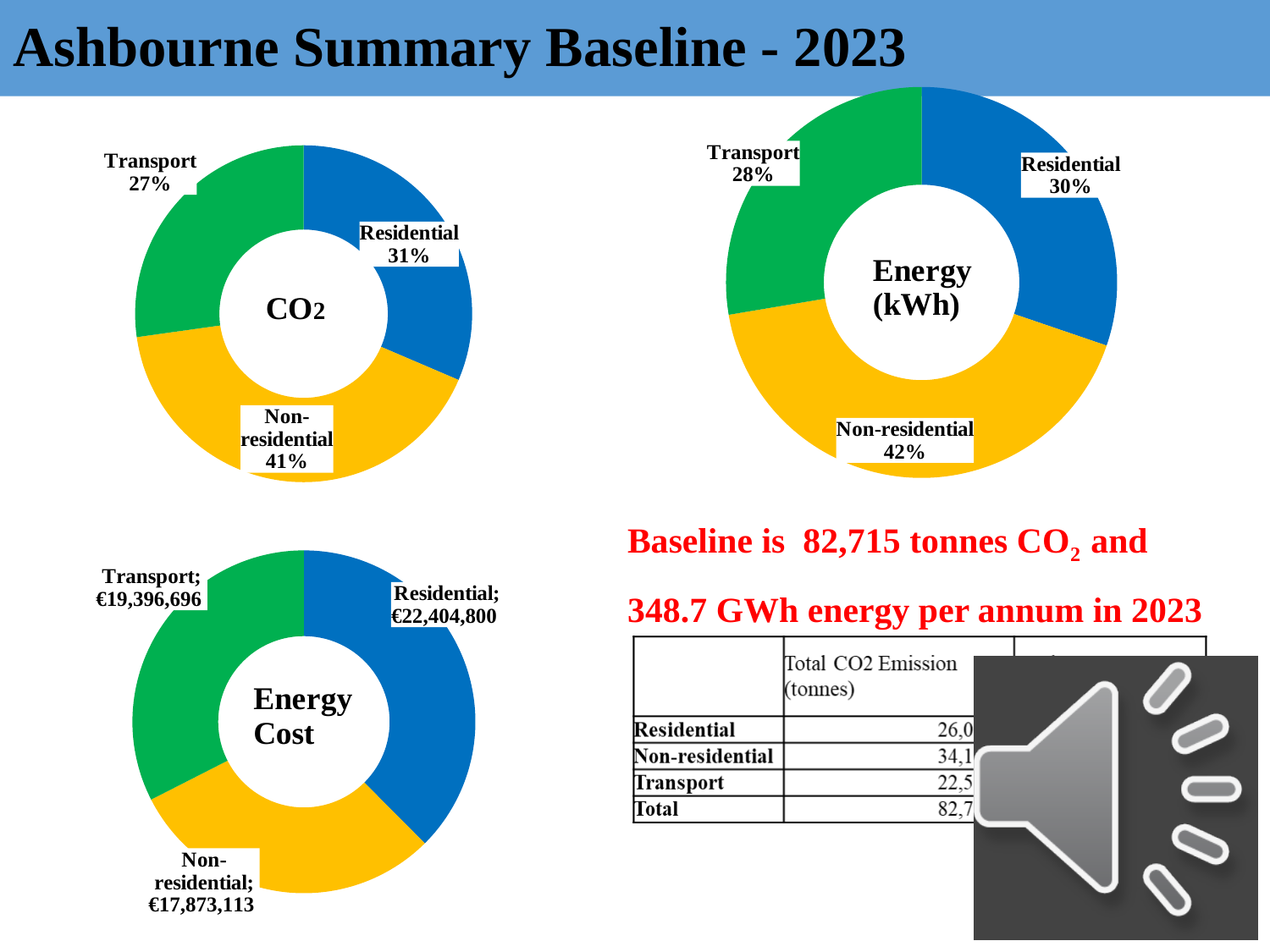
In the Energy (kWh) chart, which category has the largest share? Non-residential In the Energy Cost chart, what is the value for Residential? €22,404,800 What type of chart is the Energy Cost chart? Doughnut chart In the CO2 chart, what share does Non-residential account for? 41% In the CO2 chart, which category has the smallest share? Transport In the CO2 chart, what share does Transport account for? 27% In the Energy Cost chart, which category has the lowest value? Non-residential In the Energy (kWh) chart, what share does Residential account for? 30% In the CO2 chart, which category has the largest share? Non-residential In the Energy Cost chart, what is the value for Non-residential? €17,873,113 In the Energy (kWh) chart, what is the difference in percentage points between Non-residential and Transport? 14 In the Energy Cost chart, which is larger, Transport or Residential? Residential